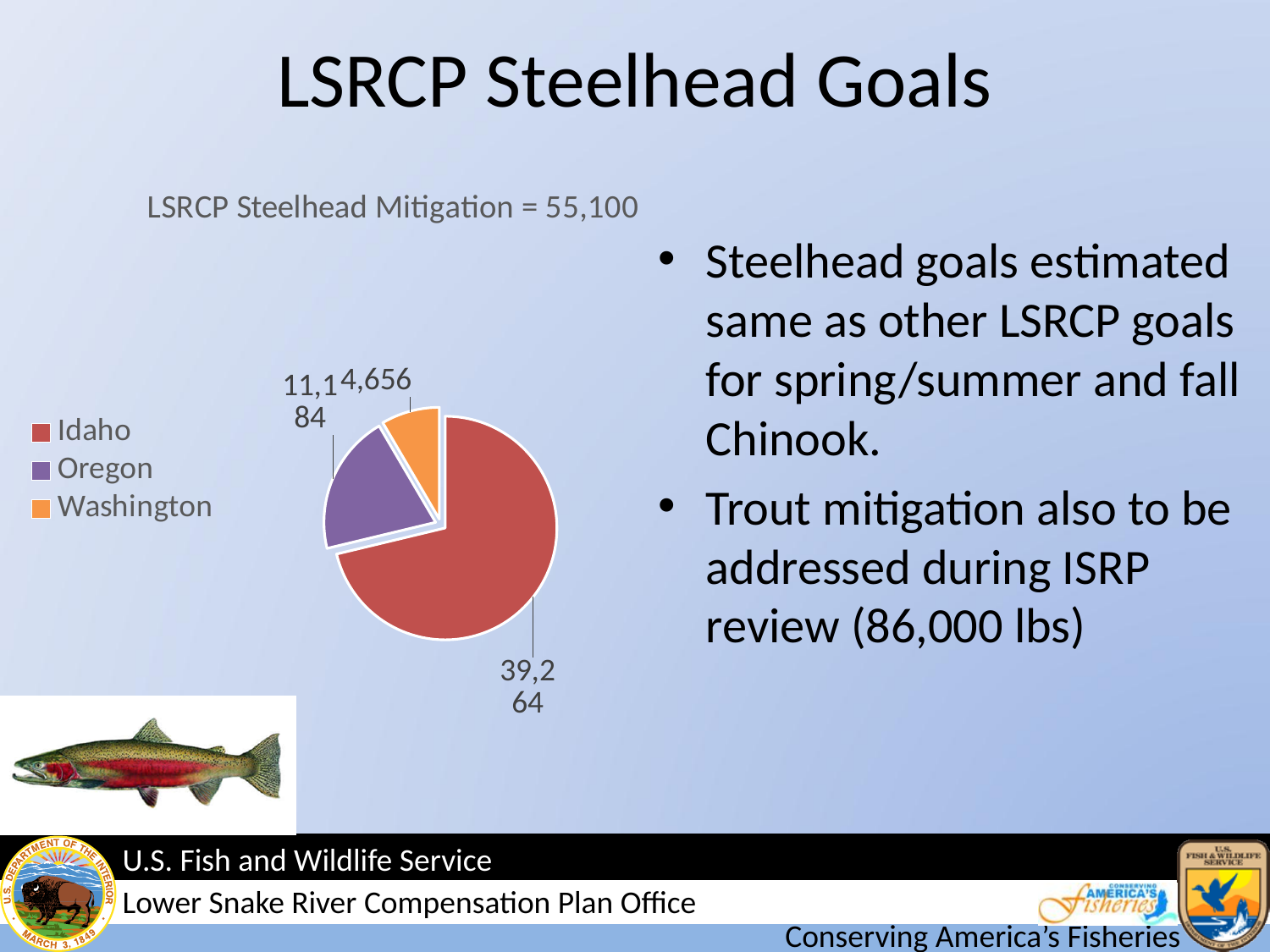
How many categories does the pie chart show? 3 Which is larger, the value for Oregon or the value for Washington? Oregon What is the value for Washington in the pie chart? 4,656 What type of chart is shown on the slide? pie chart What is the value for Idaho in the pie chart? 39,264 Which category has the largest slice in the pie chart? Idaho What is the difference between the values for Idaho and Oregon? 28,080 Which category has the smallest slice in the pie chart? Washington What is the title of the pie chart? LSRCP Steelhead Mitigation = 55,100 What is the value for Oregon in the pie chart? 11,184 Which colour represents Washington in the pie chart? orange What is the difference between the values for Oregon and Washington? 6,528